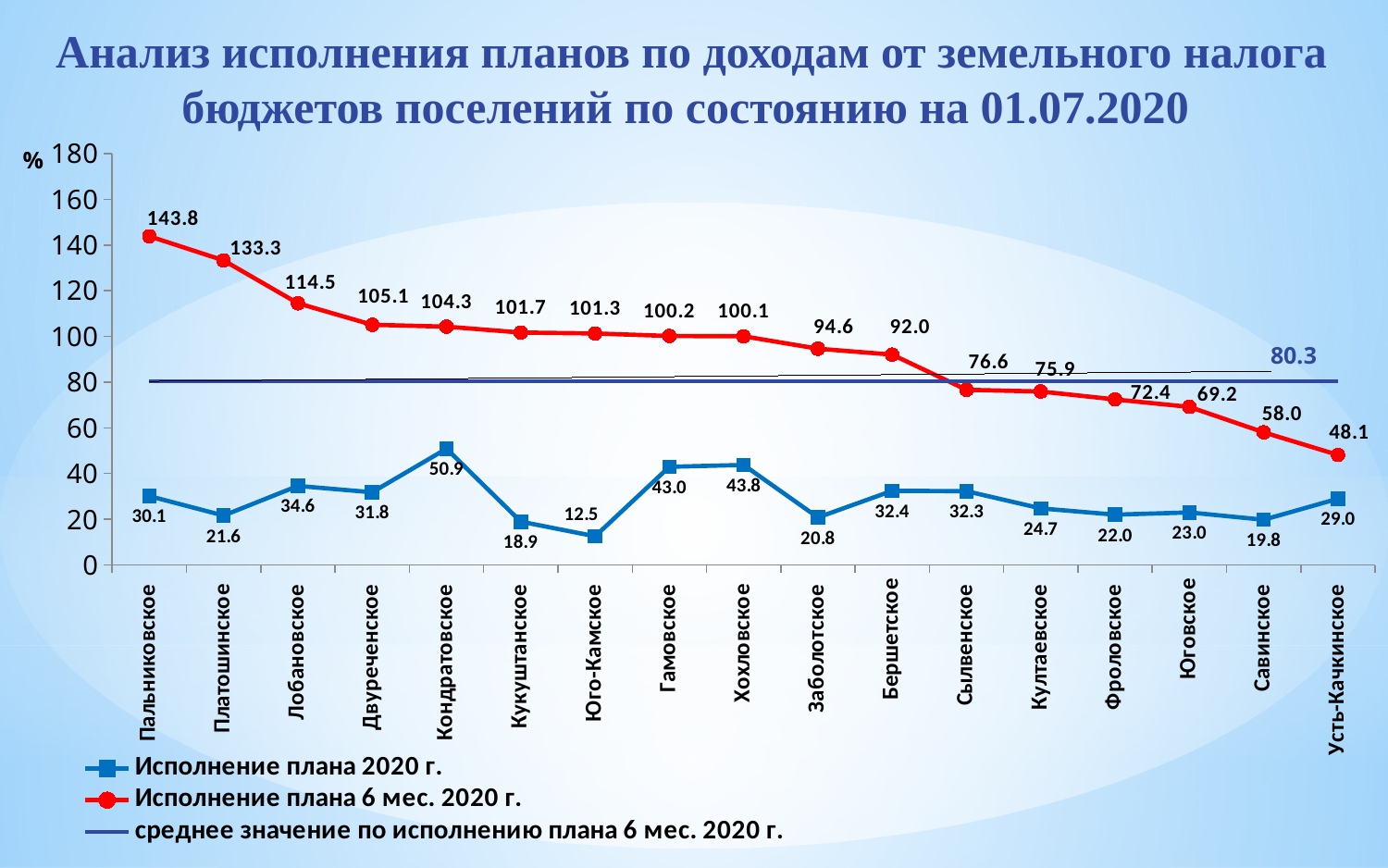
What is the value of 'Исполнение плана 2020 г.' for Кондратовское? 50.9 Which settlement has the lowest value for 'Исполнение плана 2020 г.'? Юго-Камское What unit is shown on the y axis? % How many series does the legend list? 3 What is the value of 'среднее значение по исполнению плана 6 мес. 2020 г.'? 80.3 Which settlement has the highest value for 'Исполнение плана 6 мес. 2020 г.'? Пальниковское What is the value of 'Исполнение плана 6 мес. 2020 г.' for Пальниковское? 143.8 How many settlements are shown on the x axis? 17 What type of chart is shown on the slide? line chart Which is larger for Хохловское: 'Исполнение плана 2020 г.' or 'Исполнение плана 6 мес. 2020 г.'? Исполнение плана 6 мес. 2020 г. What is the difference between the 'Исполнение плана 6 мес. 2020 г.' values for Пальниковское and Усть-Качкинское? 95.7 Does the 'Исполнение плана 6 мес. 2020 г.' series rise or fall from left to right along the x axis? fall